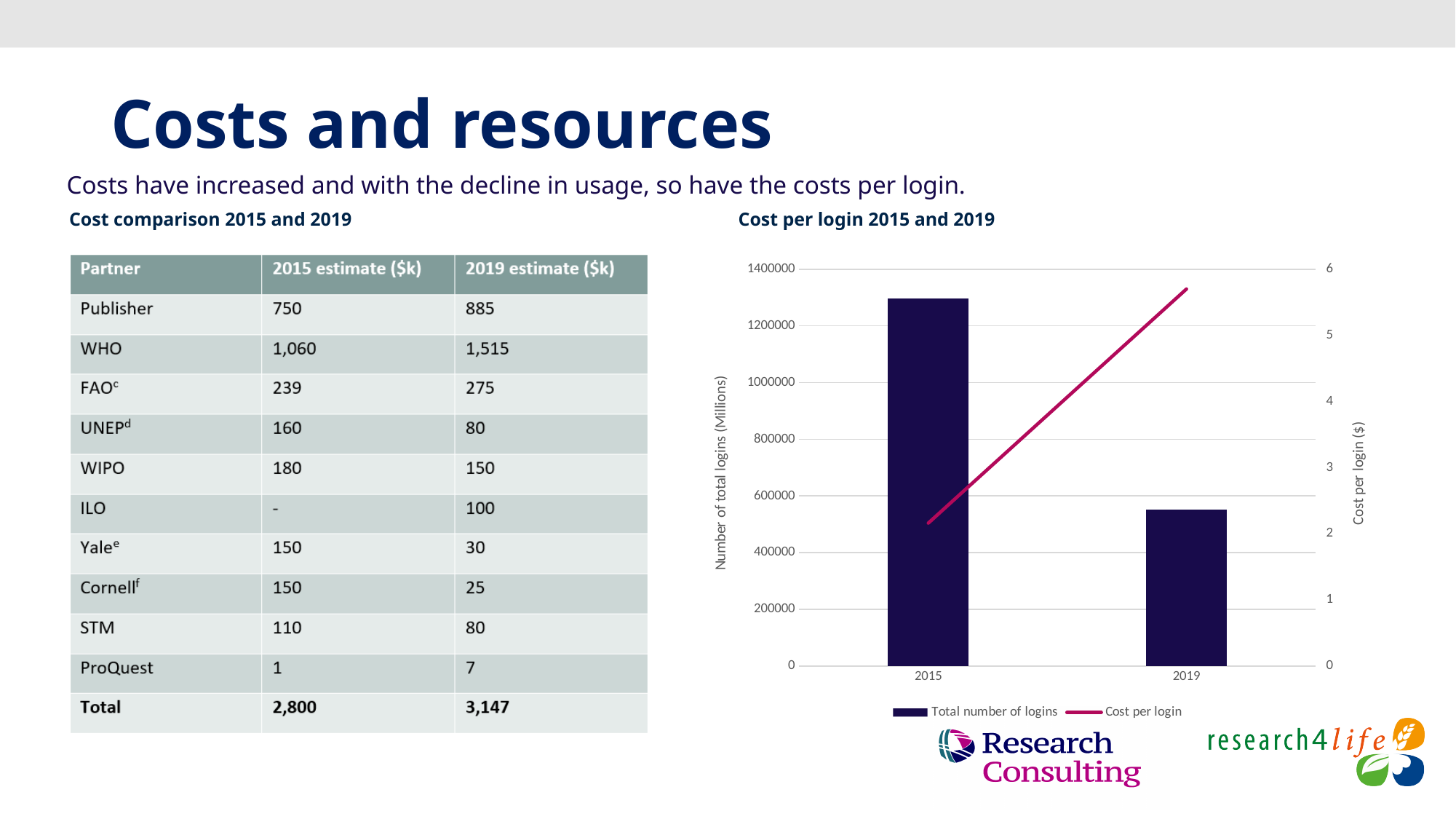
Is the total number of logins for 2015 greater or less than 1200000? greater Does the total number of logins rise or fall from 2015 to 2019? fall Is the total number of logins for 2019 greater or less than 600000? less What are the two series named in the chart's legend? Total number of logins; Cost per login How many years are shown on the x axis of the chart? 2 Which year has the lower total number of logins? 2019 What kind of chart is shown on the slide? A combined bar and line chart Which year has the higher total number of logins? 2015 Does the cost per login rise or fall from 2015 to 2019? rise How many series does the chart's legend list? 2 What is the title of the chart on the slide? Cost per login 2015 and 2019 Is the cost per login for 2019 greater or less than 5? greater